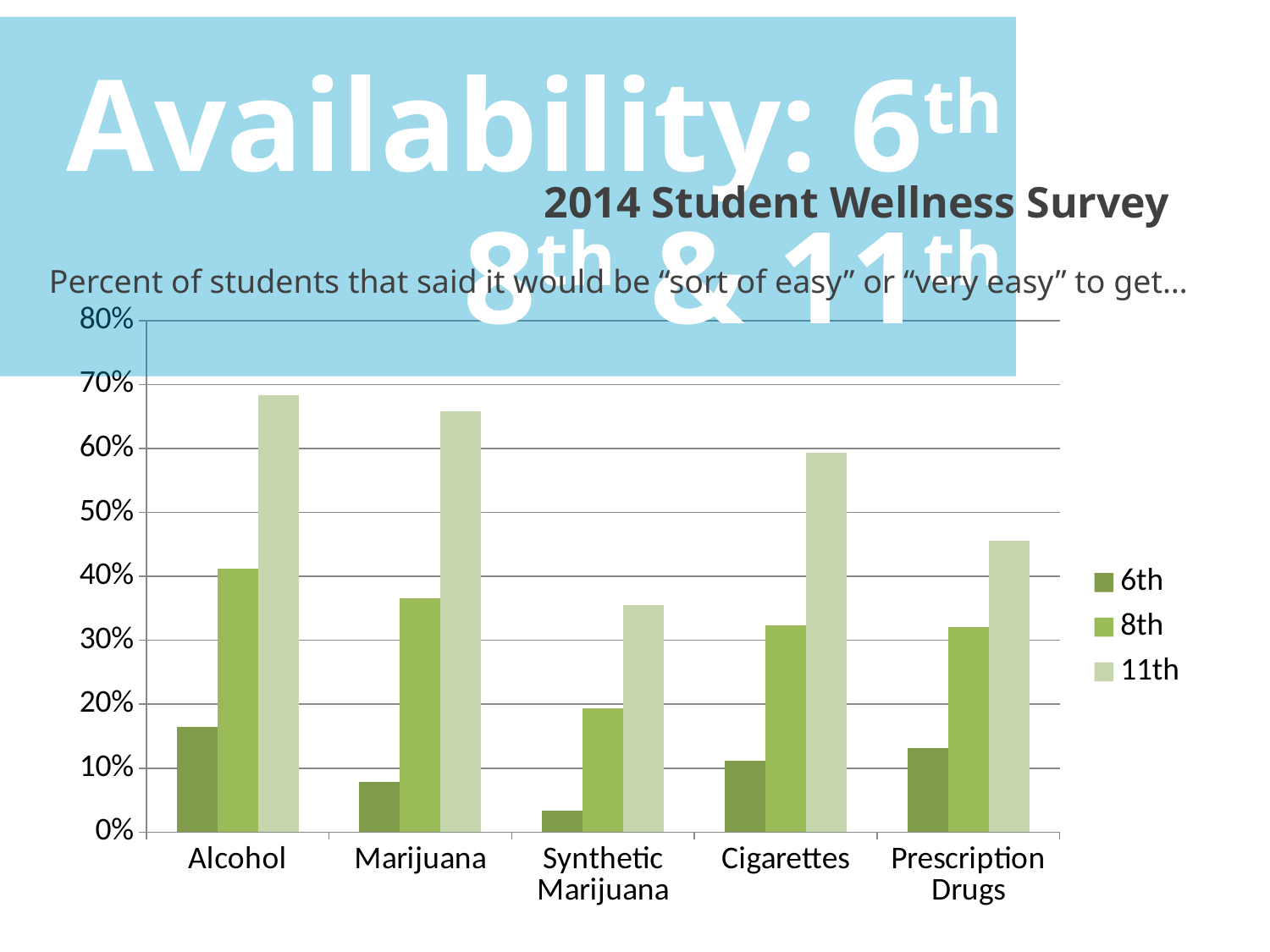
Which category has the lowest value for the 6th grade series? Synthetic Marijuana What kind of chart is shown on the slide? bar chart Is the 11th grade value for Prescription Drugs greater or less than 50%? less Is the 11th grade value for Alcohol greater or less than 60%? greater Which category has the lowest value for the 11th grade series? Synthetic Marijuana For the 11th grade series, which is larger: Cigarettes or Prescription Drugs? Cigarettes How many series does the chart's legend list? 3 For the 6th grade series, which is larger: Alcohol or Marijuana? Alcohol How many substance categories are shown on the x axis of the chart? 5 Is the 6th grade value for Synthetic Marijuana greater or less than 10%? less Which grade levels are listed in the chart's legend? 6th, 8th, 11th Which category has the highest value for the 8th grade series? Alcohol